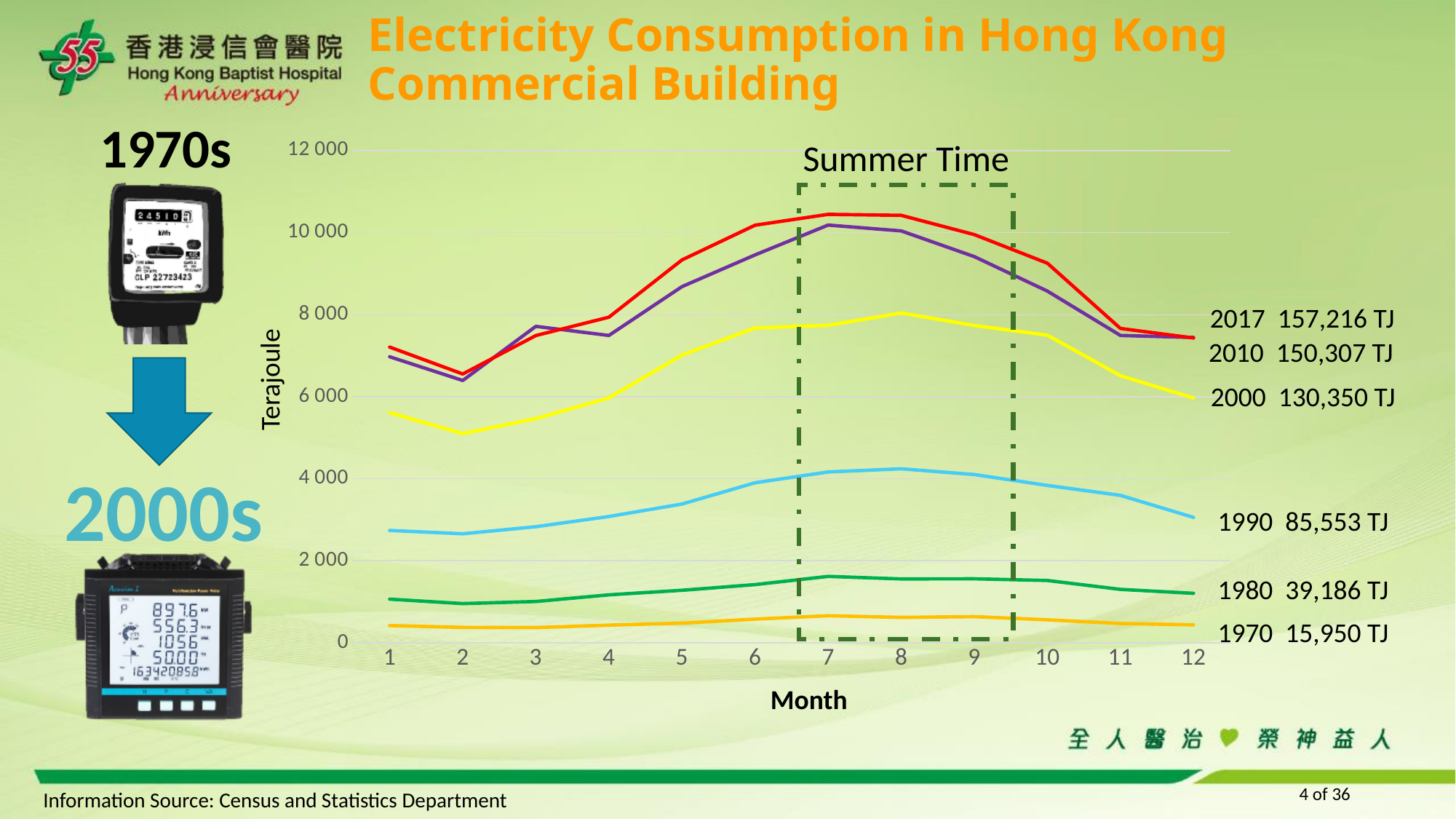
Is the value for 2017 in month 7 greater or less than 10 000? greater Which year series has the highest electricity consumption on the chart? 2017 What annual electricity consumption is printed for 1970? 15,950 TJ What kind of chart is shown on the slide? line chart Which year series has the lowest electricity consumption on the chart? 1970 What annual electricity consumption is printed for 1990? 85,553 TJ How many months are plotted along the x axis of the chart? 12 What is the difference between the annual totals printed for 2017 and 2010? 6,909 TJ What annual electricity consumption is printed for 2017? 157,216 TJ Is the value for 1980 in month 7 greater or less than 2 000? less How many year series are labelled on the chart? 6 Which has the larger annual total printed, 2000 or 1990? 2000